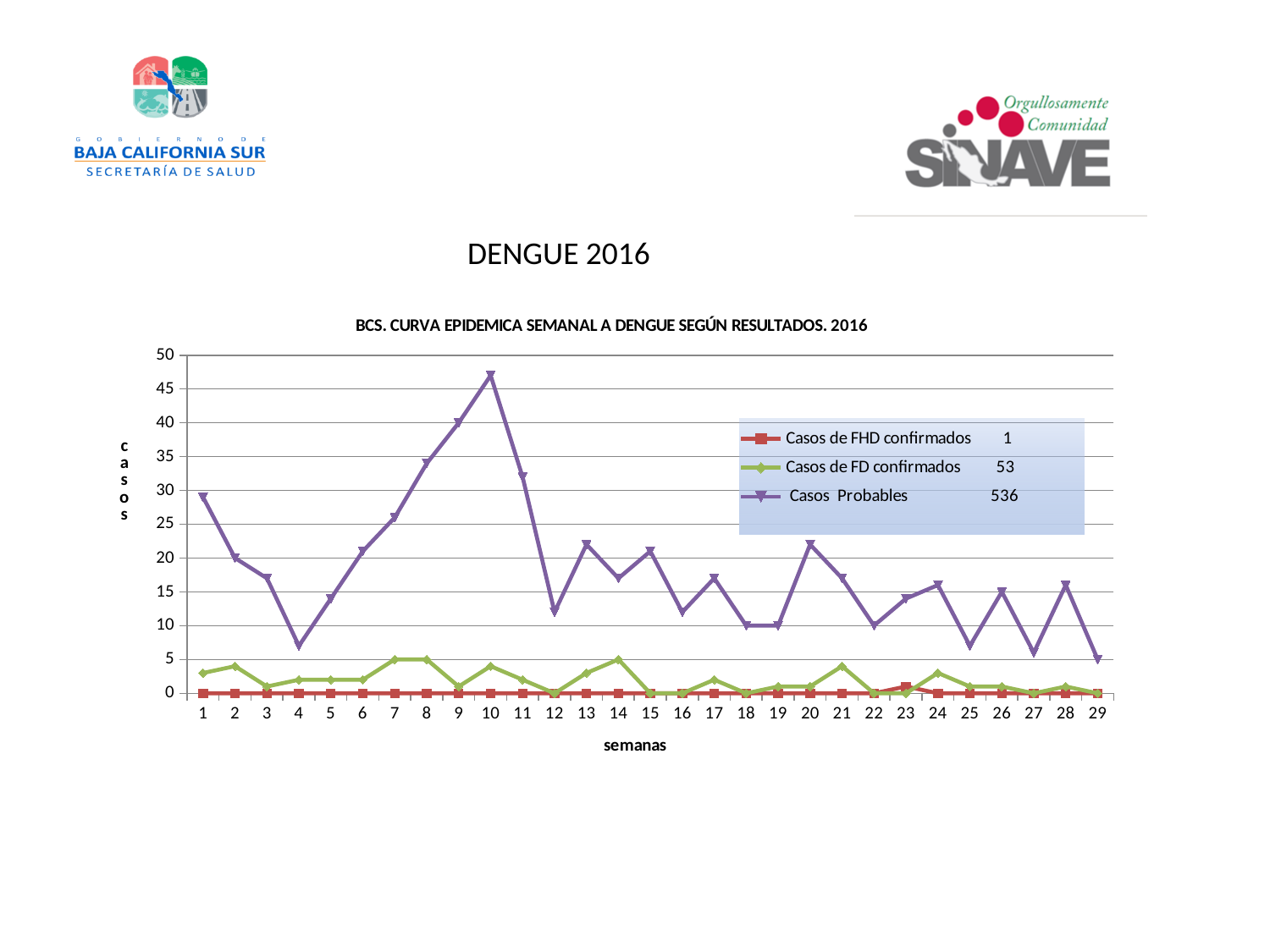
How many series does the legend list? 3 According to the legend, what is the total number of Casos de FD confirmados? 53 Which week has more Casos Probables, week 9 or week 10? week 10 According to the legend, what is the total number of Casos Probables? 536 According to the legend, what is the total number of Casos de FHD confirmados? 1 In which week do the Casos Probables reach their highest value? 10 What kind of chart is shown on the slide? line chart Do the Casos Probables rise or fall from week 7 to week 10? rise Is the value of Casos Probables in week 8 greater or less than 30? greater How many weeks (semanas) are plotted along the x axis? 29 Is the value of Casos Probables in week 4 greater or less than 10? less Is the value of Casos Probables in week 10 greater or less than 45? greater